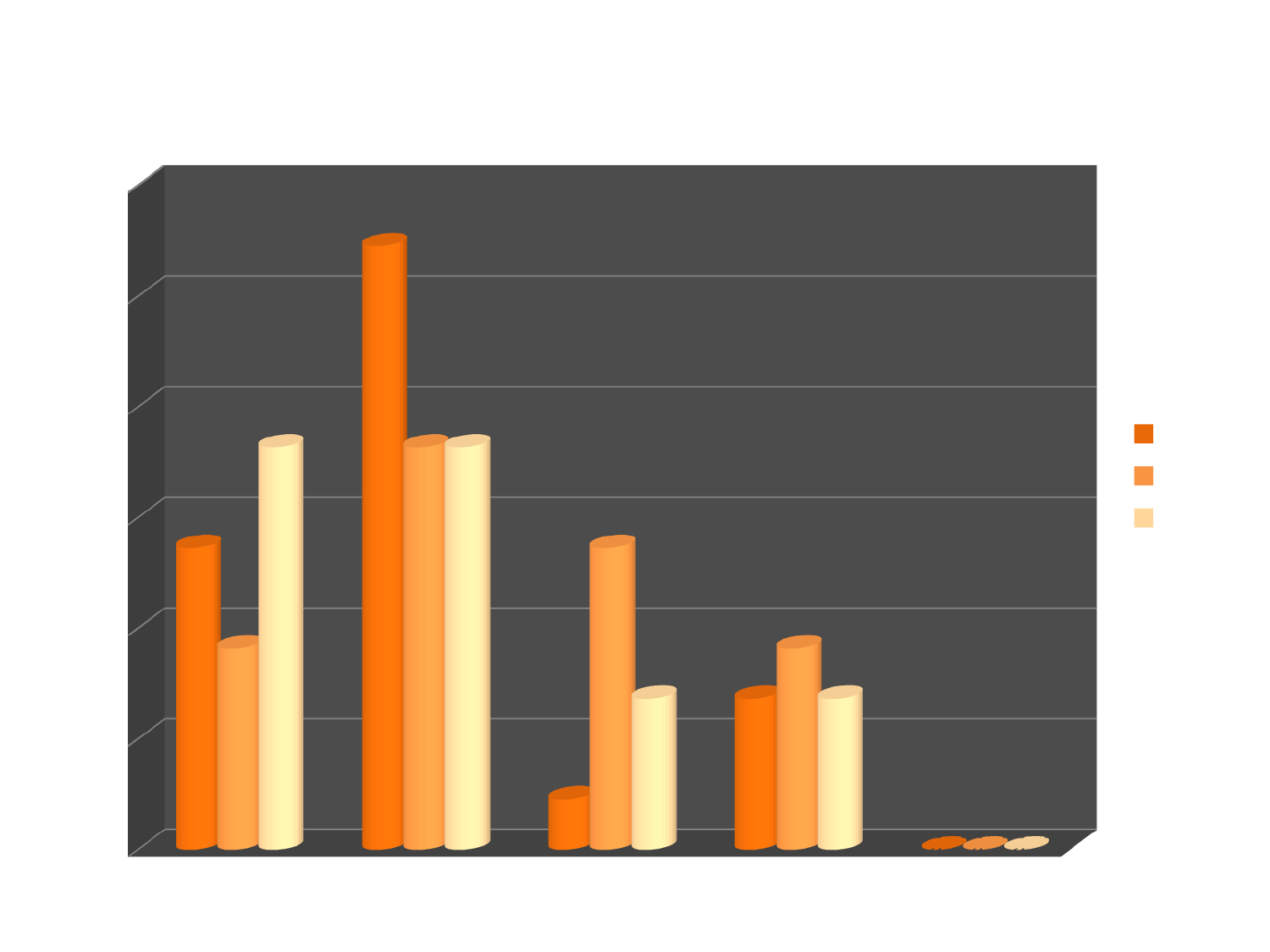
Is the tallest bar in the second group from the left taller or shorter than the tallest bar in the first group? taller Which group of bars, counting from the left, contains the tallest bar on the chart? second What colour is the first series swatch in the legend? dark orange How many series does the legend list? 3 What colour is the third series swatch in the legend? pale yellow Which group of bars, counting from the left, has the shortest bars overall? fifth How many groups of bars are plotted along the x axis? 5 What kind of chart is shown on the slide? bar chart